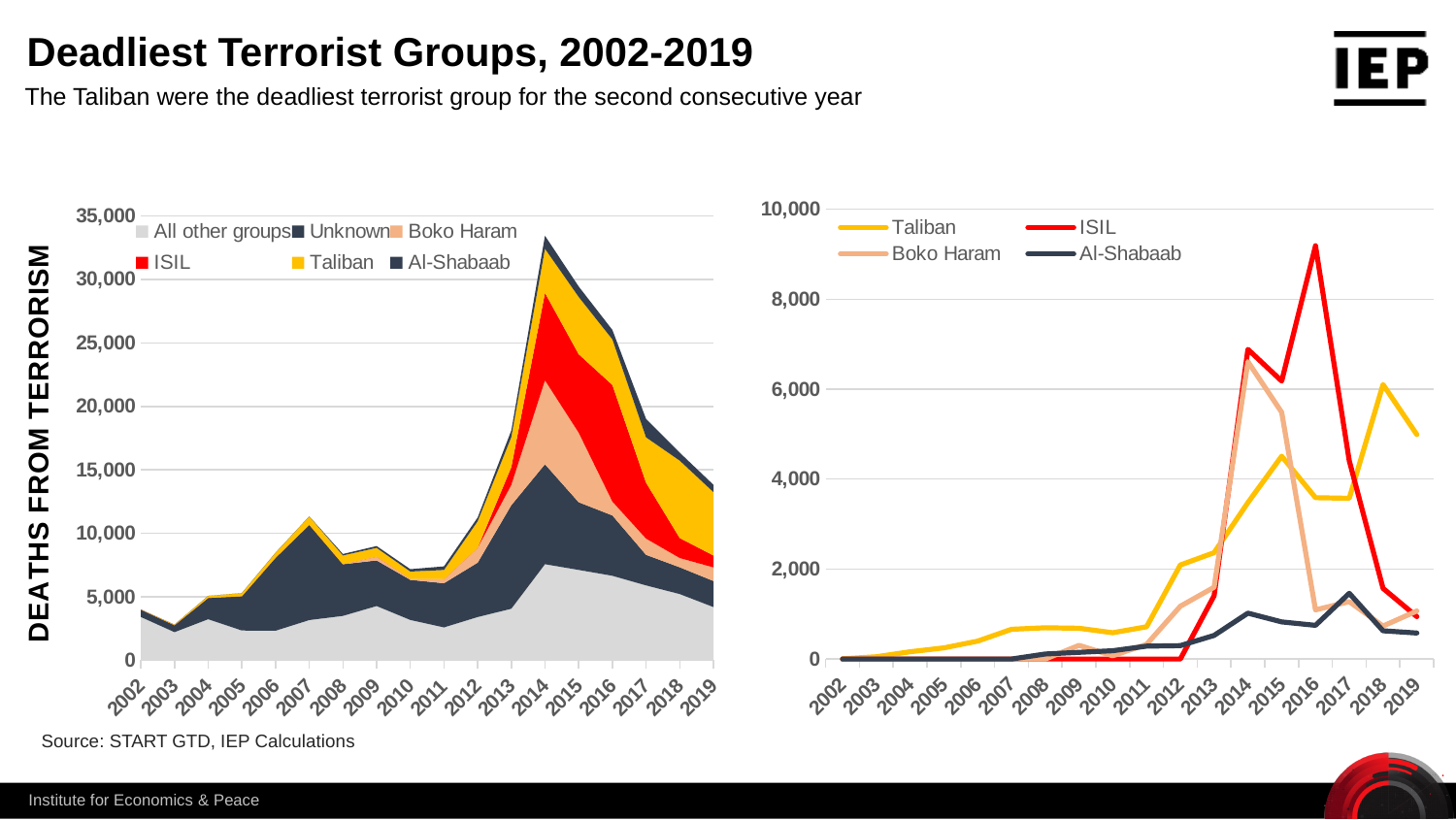
In the right chart, does the ISIL line rise or fall from 2016 to 2019? Fall In the right chart, is the value for ISIL in 2016 greater or less than 8,000? greater In the right chart, in which year does the ISIL line reach its peak? 2016 How many years are shown on the x axis of the right chart? 18 What is the title of the vertical axis on the left chart? DEATHS FROM TERRORISM How many series does the legend of the left chart list? 6 What kind of chart is the left chart on the slide? Stacked area chart In the left chart, in which year is the total number of deaths from terrorism highest? 2014 In the left chart, is the total for 2014 greater or less than 30,000? greater What kind of chart is the right chart on the slide? Line chart How many series does the legend of the right chart list? 4 In the right chart, which is larger in 2019, the value for the Taliban or the value for ISIL? Taliban